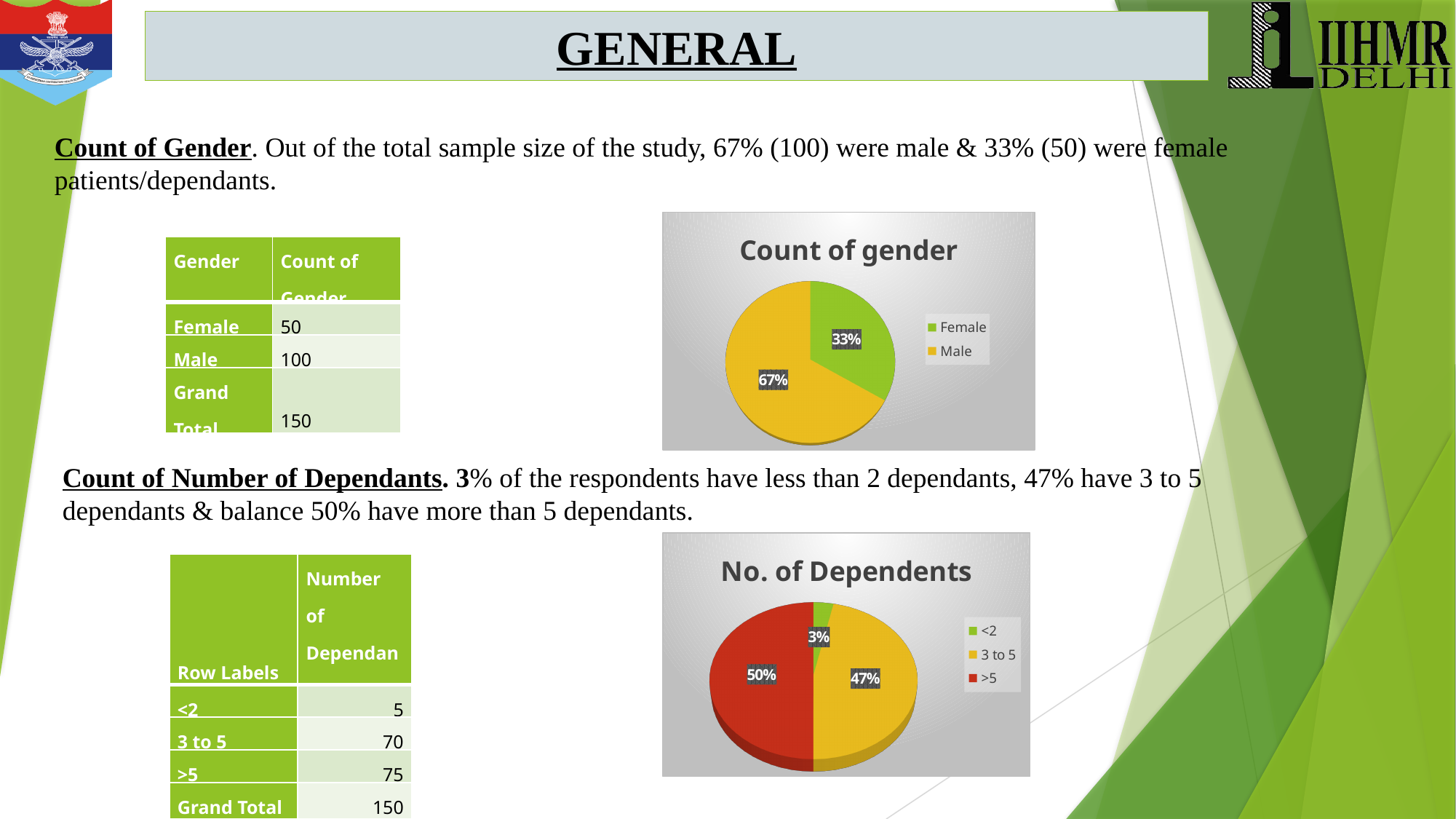
In the 'No. of Dependents' chart, what share of the pie is '>5'? 50% In the 'No. of Dependents' chart, what is the difference in percentage points between the '>5' and '<2' slices? 47 percentage points In the 'No. of Dependents' chart, which category has the smallest slice? <2 How many categories does the legend of the 'No. of Dependents' chart list? 3 In the 'No. of Dependents' chart, which colour represents the '>5' category? Red In the 'Count of gender' chart, what share of the pie is Female? 33% How many categories does the legend of the 'Count of gender' chart list? 2 In the 'Count of gender' chart, which category has the largest slice? Male In the 'No. of Dependents' chart, what share of the pie is '3 to 5'? 47% What kind of chart is the 'Count of gender' chart? Pie chart In the 'Count of gender' chart, what is the difference in percentage points between the Male and Female slices? 34 percentage points